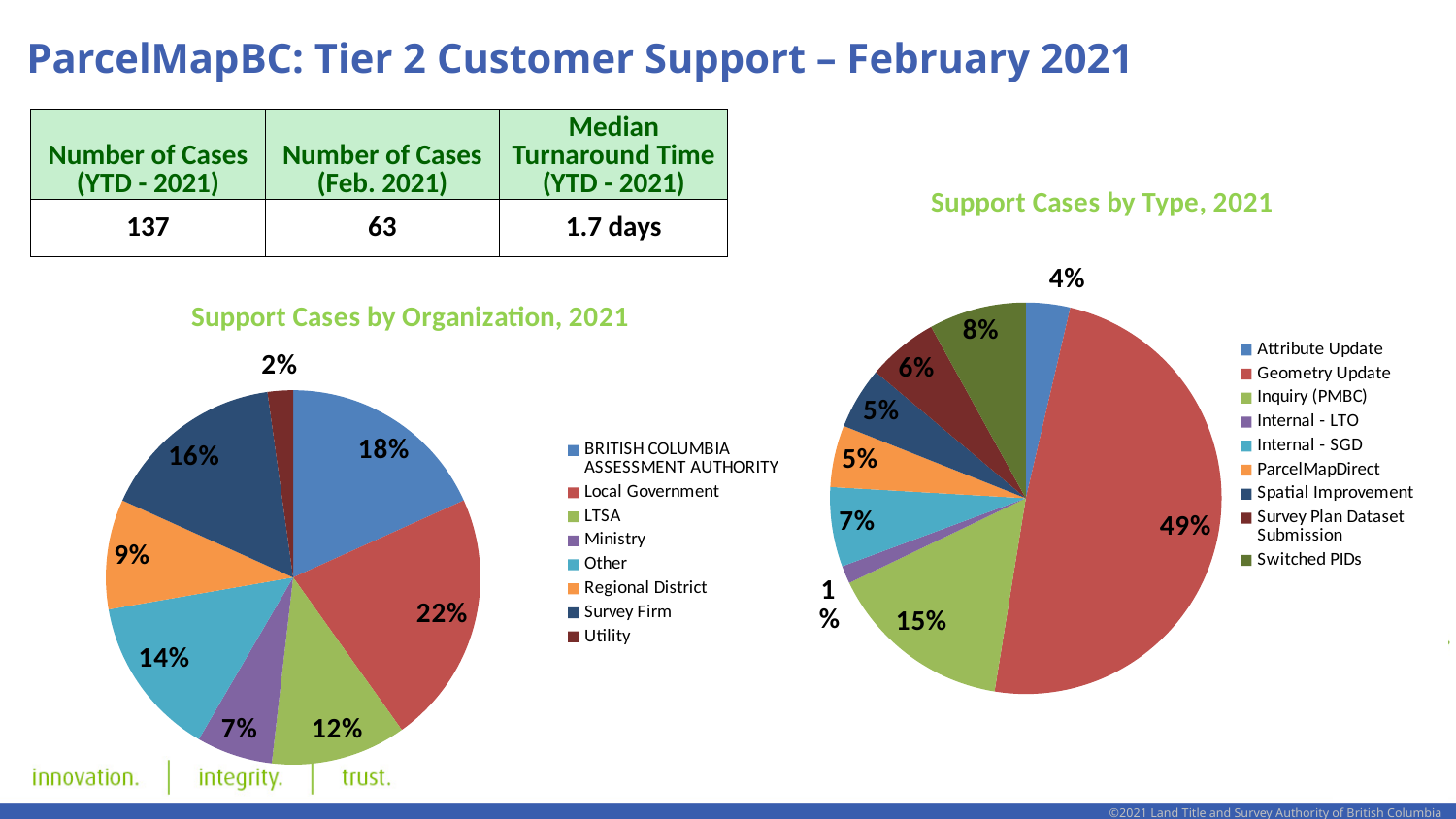
In the Support Cases by Type, 2021 chart, how many case types does the legend list? 9 In the Support Cases by Type, 2021 chart, what share of cases is Geometry Update? 49% In the Support Cases by Type, 2021 chart, which type has the smallest share? Internal - LTO In the Support Cases by Type, 2021 chart, what share of cases is Switched PIDs? 8% In the Support Cases by Organization, 2021 chart, what is the difference between the Other share and the Ministry share? 7% In the Support Cases by Organization, 2021 chart, how many organizations does the legend list? 8 In the Support Cases by Organization, 2021 chart, what share of cases is Local Government? 22% In the Support Cases by Type, 2021 chart, which is larger, Inquiry (PMBC) or Internal - SGD? Inquiry (PMBC) In the Support Cases by Organization, 2021 chart, which organization has the smallest share? Utility What kind of chart is the Support Cases by Type, 2021 chart? Pie chart In the Support Cases by Organization, 2021 chart, which organization has the largest share? Local Government